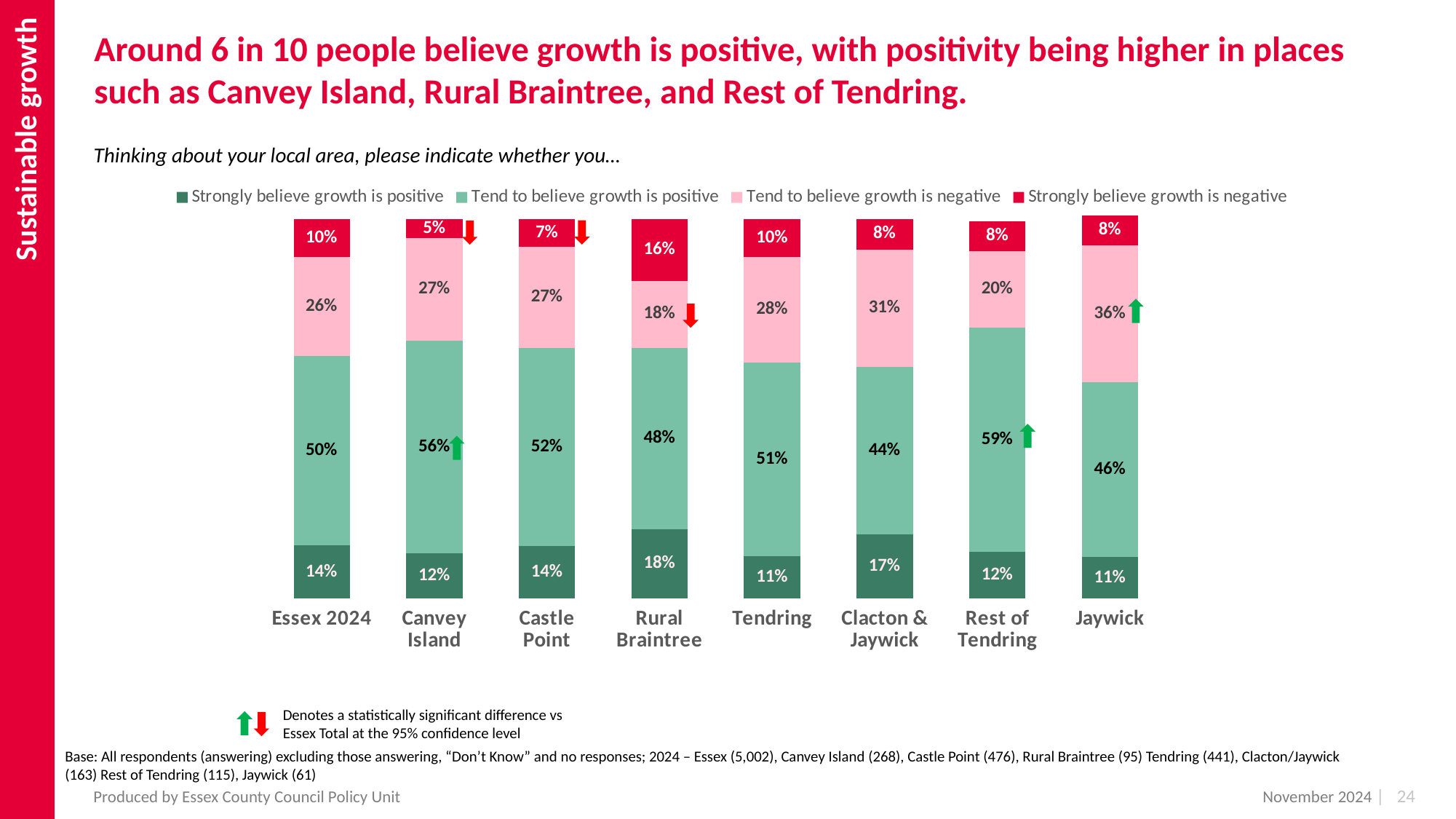
What percentage of respondents in Rural Braintree strongly believe growth is negative? 16% What kind of chart is shown on the slide? Stacked bar chart Which area has the highest share of respondents who strongly believe growth is positive? Rural Braintree Which area has the highest share of respondents who tend to believe growth is negative? Jaywick How many percentage points higher is the 'Tend to believe growth is negative' share for Jaywick than for Essex 2024? 10 percentage points What percentage of respondents in Rest of Tendring tend to believe growth is positive? 59% What is the combined share of respondents in Essex 2024 who strongly or tend to believe growth is positive? 64% What percentage of respondents in Clacton & Jaywick strongly believe growth is positive? 17% Which has a larger 'Tend to believe growth is positive' share, Canvey Island or Castle Point? Canvey Island How many series does the chart legend list? 4 How many areas are shown on the x axis of the chart? 8 Which area has the lowest share of respondents who strongly believe growth is negative? Canvey Island